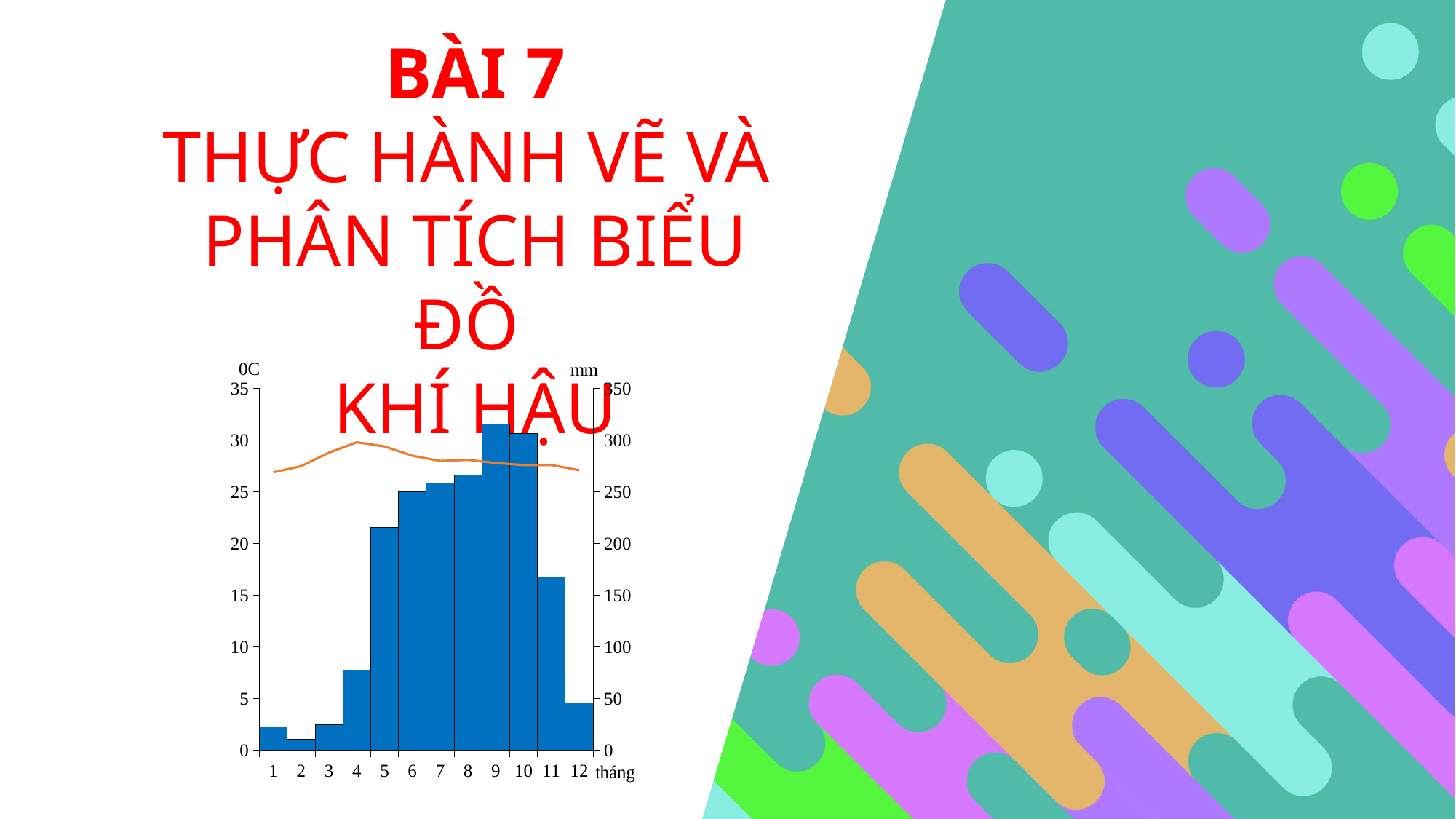
Is the bar for month 11 greater or less than 150 on the right (mm) axis? greater What unit is labelled on the right-hand axis of the chart? mm What kind of chart is shown on the slide? A bar chart combined with a line chart Is the bar for month 9 greater or less than 300 on the right (mm) axis? greater Is the bar for month 4 greater or less than 100 on the right (mm) axis? less How many months are plotted along the x axis of the chart? 12 Which month has the shortest bar in the chart? 2 What label is written at the end of the x axis of the chart? tháng Which month has the tallest bar in the chart? 9 Do the bars rise or fall from month 1 to month 9? Rise Which bar is taller, month 5 or month 11? Month 5